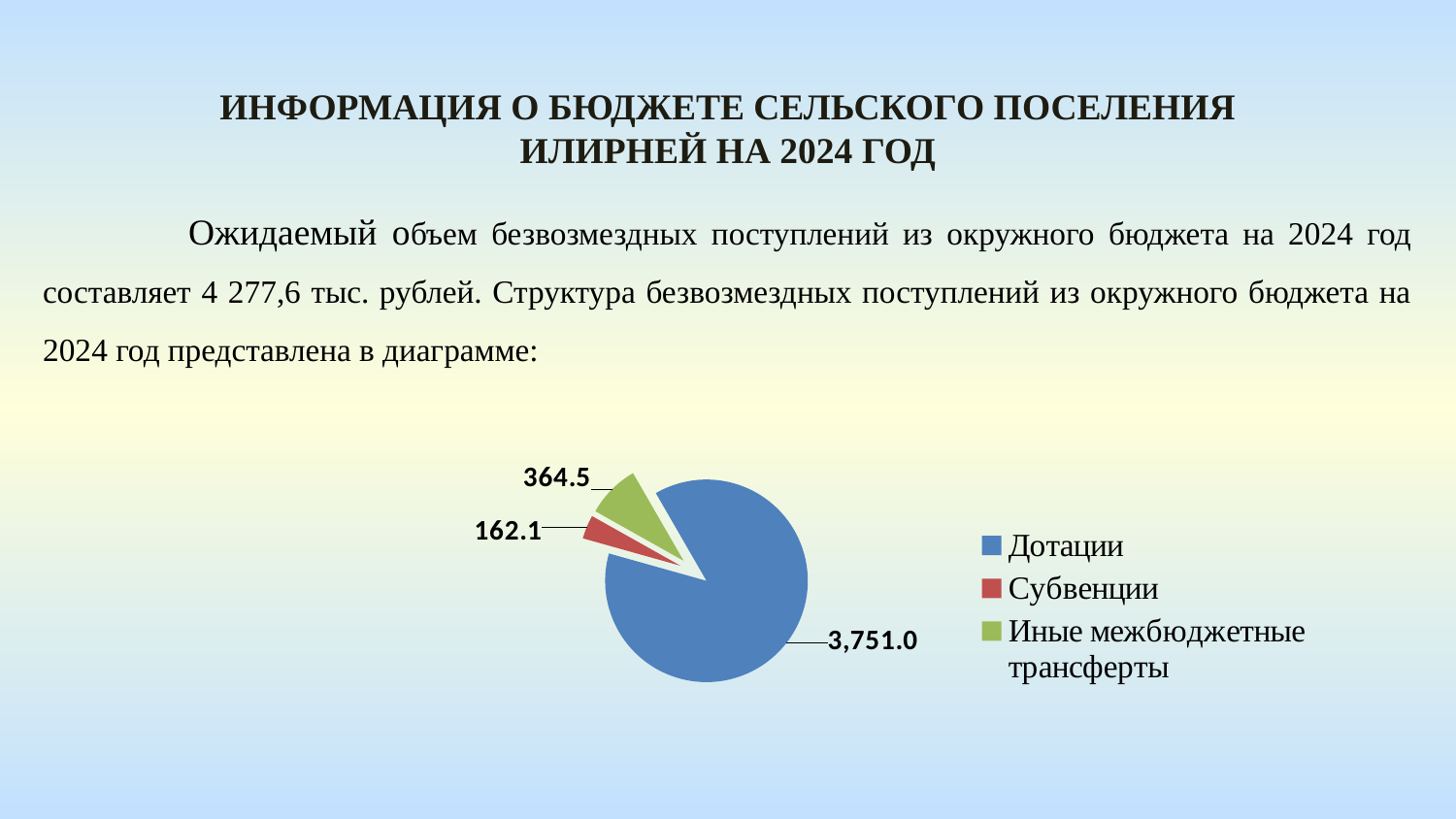
What is the total of all slices in the pie chart? 4,277.6 What type of chart is shown on the slide? Pie chart Which category has the smallest slice in the pie chart? Субвенции How many slices does the pie chart have? 3 What is the difference between the values for Иные межбюджетные трансферты and Субвенции? 202.4 What colour is the slice for Дотации in the pie chart? Blue What is the value for Дотации in the pie chart? 3,751.0 What is the value for Иные межбюджетные трансферты in the pie chart? 364.5 What is the difference between the values for Дотации and Иные межбюджетные трансферты? 3,386.5 Which category has the largest slice in the pie chart? Дотации Which is larger, the value for Субвенции or the value for Иные межбюджетные трансферты? Иные межбюджетные трансферты What is the value for Субвенции in the pie chart? 162.1